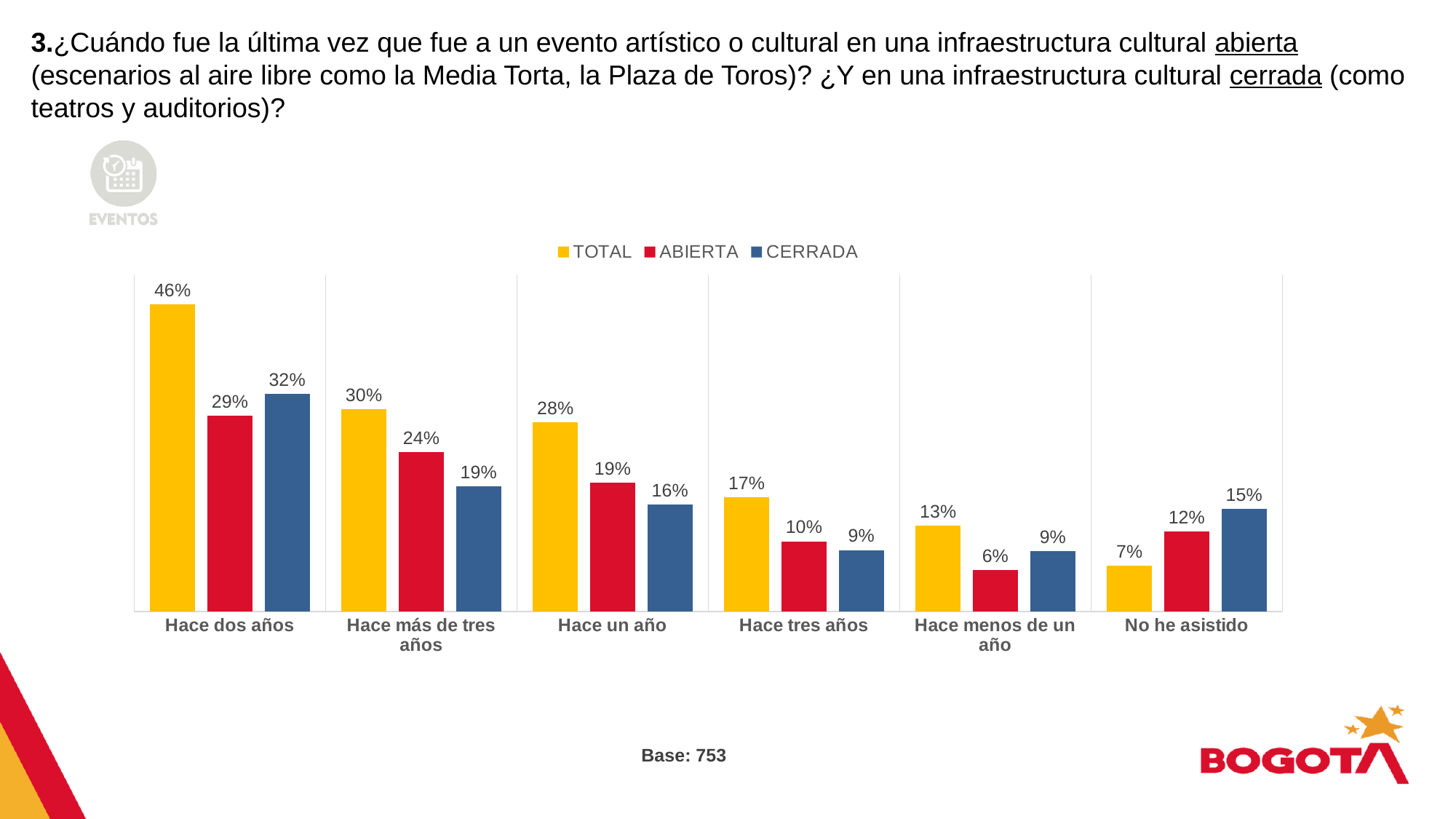
Which category has the lowest ABIERTA value? Hace menos de un año Which category has the highest TOTAL value? Hace dos años How many categories are shown on the x axis? 6 How many series does the legend list? 3 What is the base (sample size) shown below the chart? 753 What kind of chart is shown on the slide? Bar chart For "No he asistido", which is larger: the ABIERTA value or the CERRADA value? CERRADA Which colour represents the TOTAL series in the legend? Yellow What is the difference between the CERRADA and ABIERTA values for "Hace dos años"? 3% What is the ABIERTA value for "Hace más de tres años"? 24% What is the TOTAL value for "Hace dos años"? 46% What is the CERRADA value for "No he asistido"? 15%